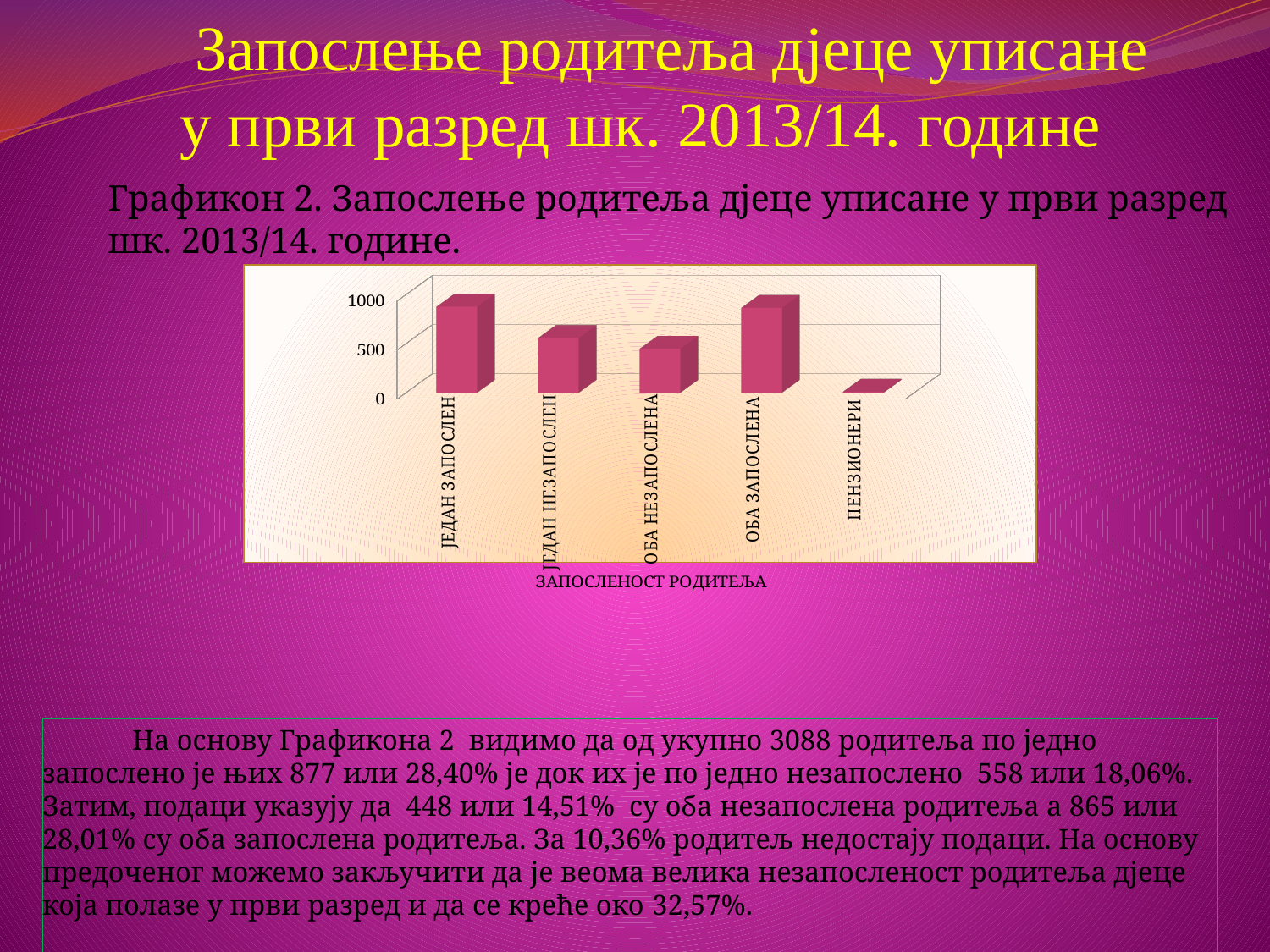
Which category has the lowest bar in the chart? ПЕНЗИОНЕРИ What kind of chart is shown on the slide? bar chart What is the highest value shown on the vertical axis of the chart? 1000 Is the value for ОБА ЗАПОСЛЕНА greater or less than 500? greater Which is larger, the value for ОБА ЗАПОСЛЕНА or the value for ОБА НЕЗАПОСЛЕНА? ОБА ЗАПОСЛЕНА Is the value for ЈЕДАН ЗАПОСЛЕН greater or less than 500? greater Which is larger, the value for ЈЕДАН ЗАПОСЛЕН or the value for ЈЕДАН НЕЗАПОСЛЕН? ЈЕДАН ЗАПОСЛЕН How many categories are shown on the x axis of the chart? 5 Is the value for ОБА НЕЗАПОСЛЕНА greater or less than 500? less What is the title of the x axis of the chart? ЗАПОСЛЕНОСТ РОДИТЕЉА